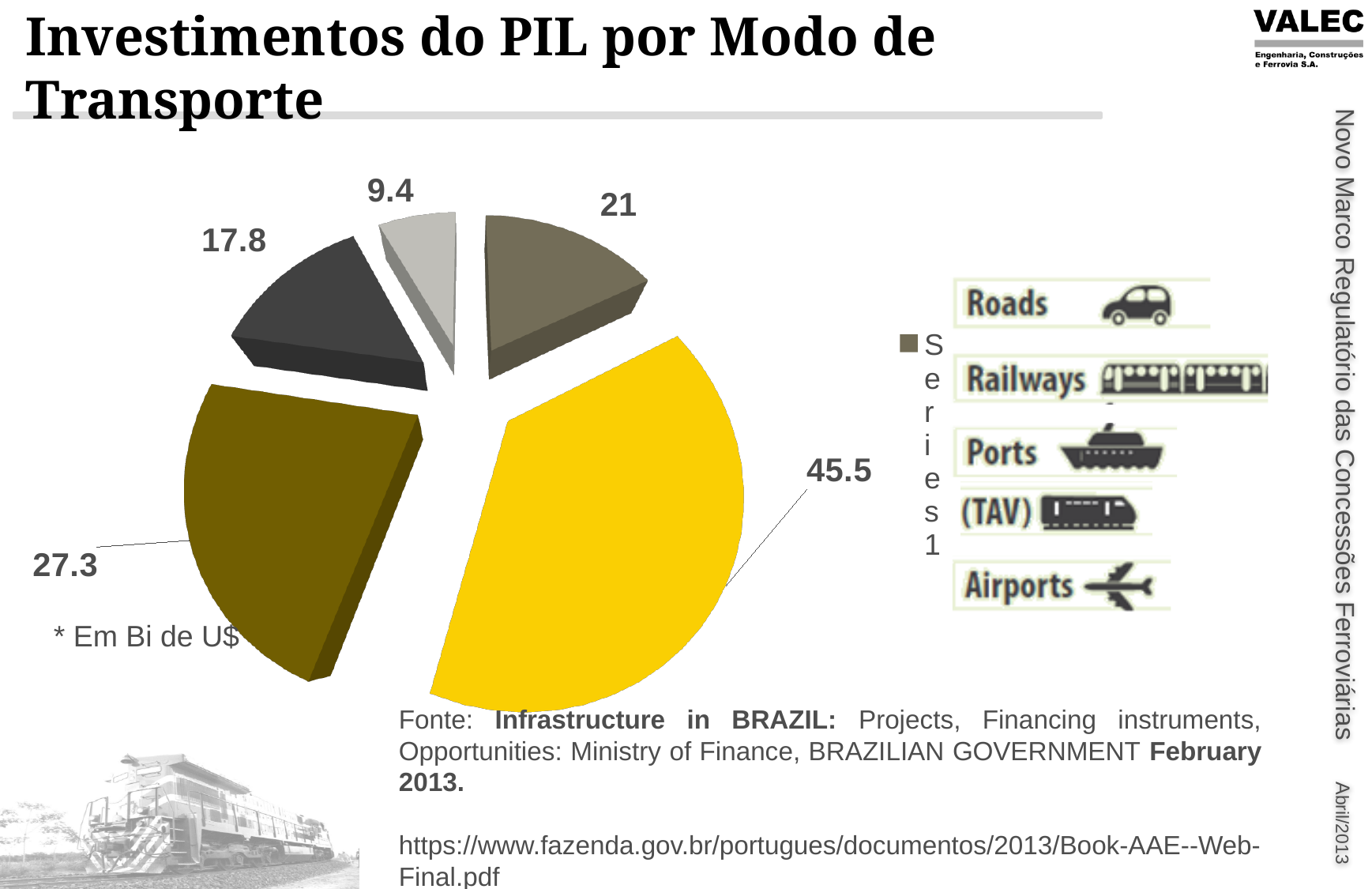
Which is larger, the slice labelled 21 or the slice labelled 17.8? 21 What value is labelled on the light grey slice at the top of the pie chart? 9.4 What unit note is printed below the pie chart? * Em Bi de U$ How many slices does the pie chart have? 5 What kind of chart is shown on the slide? Pie chart What is the value of the largest slice in the pie chart? 45.5 What is the total of all the slice values shown in the pie chart? 121 What series name does the chart legend show? Series1 What value is labelled on the yellow slice of the pie chart? 45.5 What value is labelled on the dark olive slice on the left of the pie chart? 27.3 What is the value of the smallest slice in the pie chart? 9.4 What is the difference between the two largest slice values (45.5 and 27.3)? 18.2